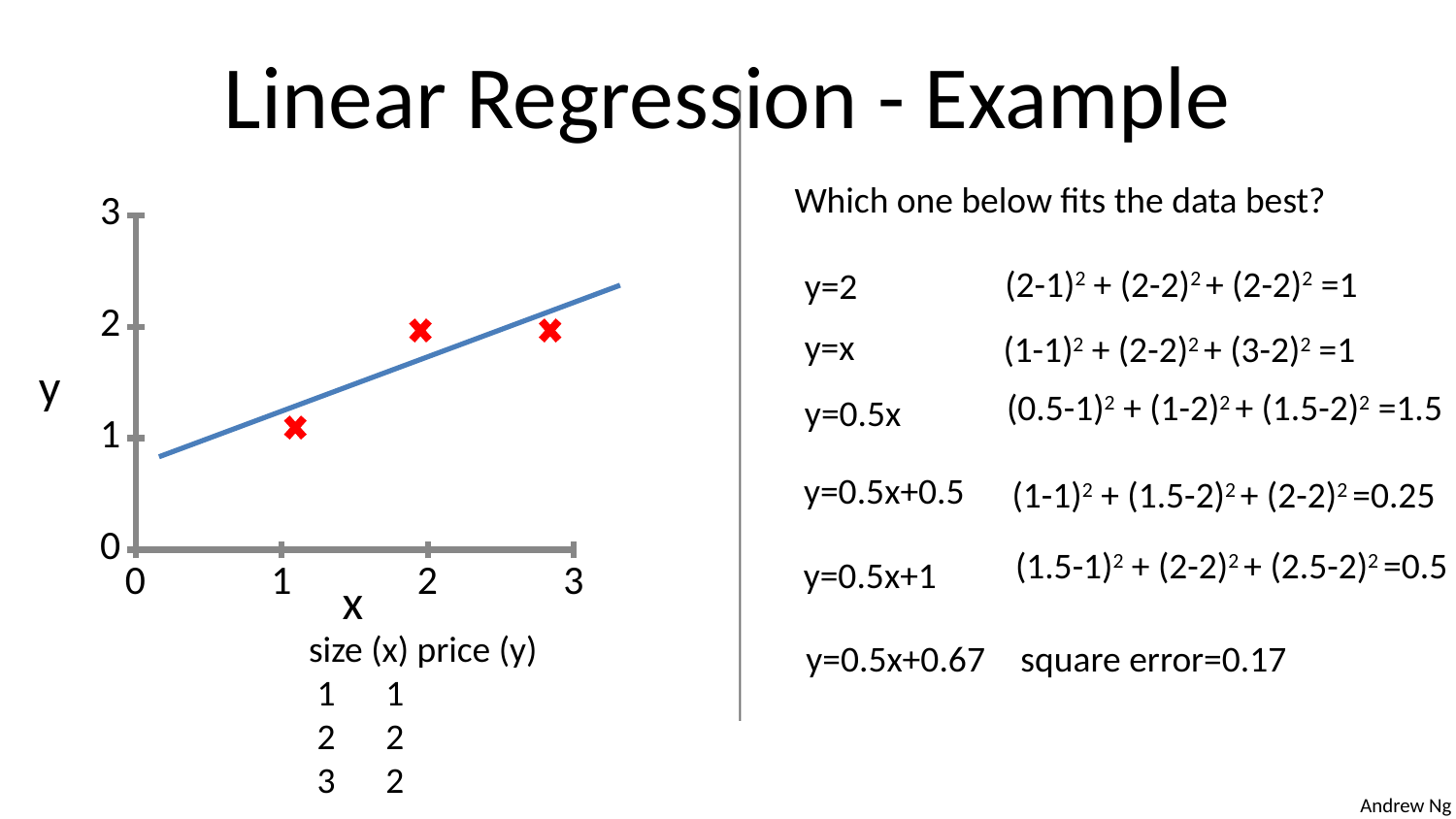
What kind of chart is shown on the slide? scatter chart What is the price (y) value for size (x) = 2? 2 What is the price (y) value for size (x) = 1? 1 Is the price (y) for size (x) = 1 larger or smaller than the price (y) for size (x) = 2? smaller What colour is the fitted line drawn through the data points? blue Is the y value of the point at x = 3 greater or less than 1? greater How many data points are plotted on the chart? 3 What is the label on the horizontal axis of the chart? x Do the plotted y values generally rise or fall as x increases? rise Which size (x) value has the lowest price (y)? 1 What is the difference between the price (y) at x = 2 and the price (y) at x = 1? 1 What is the price (y) value for size (x) = 3? 2